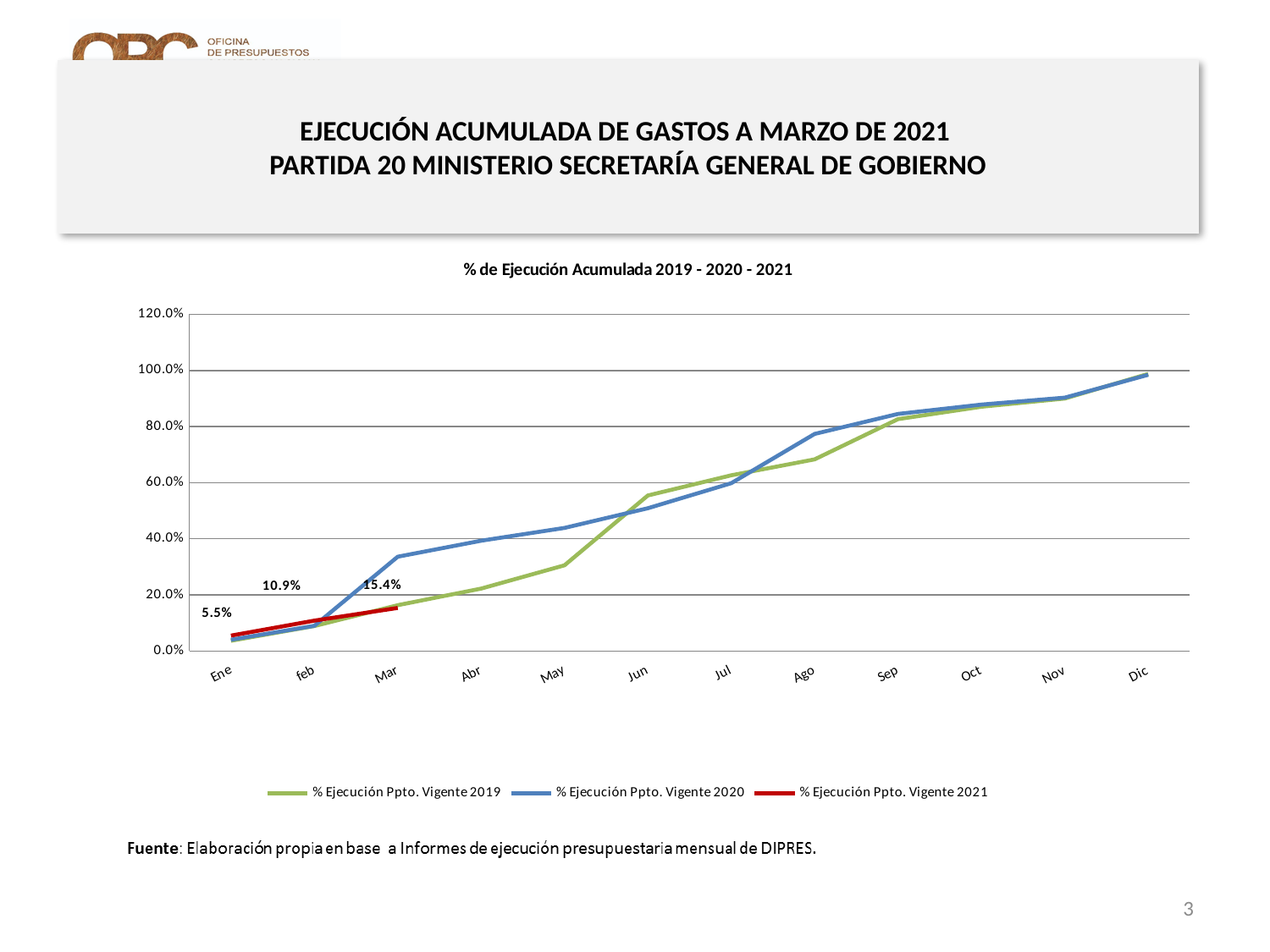
What is the value of % Ejecución Ppto. Vigente 2021 in Mar? 15.4% What is the value of % Ejecución Ppto. Vigente 2021 in Ene? 5.5% What is the value of % Ejecución Ppto. Vigente 2021 in feb? 10.9% Do the values for % Ejecución Ppto. Vigente 2020 rise or fall from Ene to Dic? Rise What is the difference between the 2021 values in Mar and Ene? 9.9% What is the difference between the 2021 values in feb and Ene? 5.4% Is the value for % Ejecución Ppto. Vigente 2020 in Mar greater or less than 20.0%? greater What is the title of the chart? % de Ejecución Acumulada 2019 - 2020 - 2021 How many months are shown on the x axis? 12 In Ago, which series has the higher value: % Ejecución Ppto. Vigente 2019 or % Ejecución Ppto. Vigente 2020? % Ejecución Ppto. Vigente 2020 What kind of chart is shown on the slide? Line chart How many series does the legend list? 3